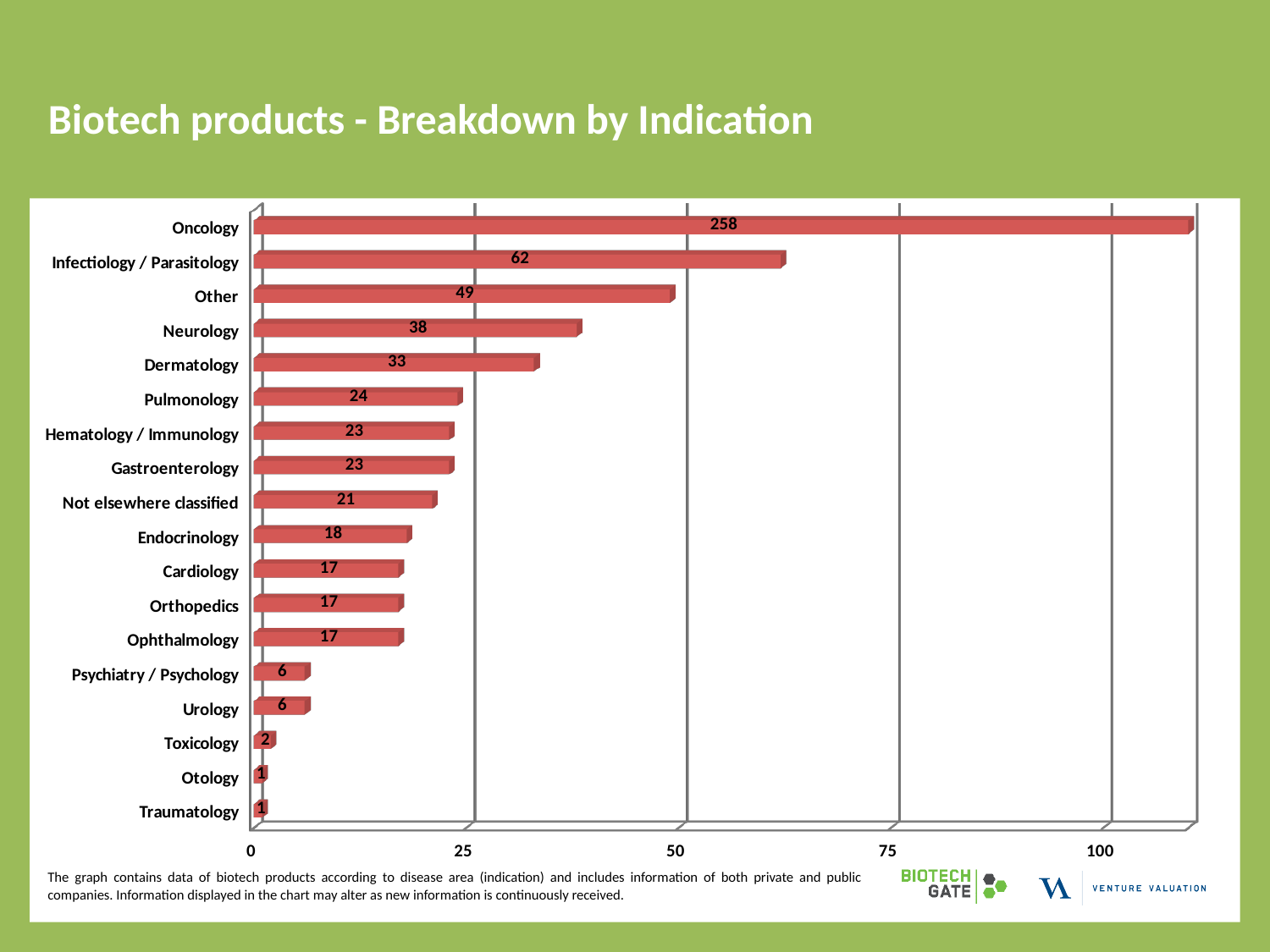
How many indication categories are shown in the chart? 18 What is the value for Endocrinology? 18 Is the value for Neurology greater or less than 25? greater Which is larger, the value for Pulmonology or the value for Not elsewhere classified? Pulmonology What is the value for Dermatology? 33 What is the difference between the values for Other and Neurology? 11 Which indication has the highest value? Oncology What is the title of the slide? Biotech products - Breakdown by Indication What is the value for Oncology? 258 What kind of chart is shown on the slide? Bar chart What is the difference between the values for Oncology and Infectiology / Parasitology? 196 What is the value for Infectiology / Parasitology? 62